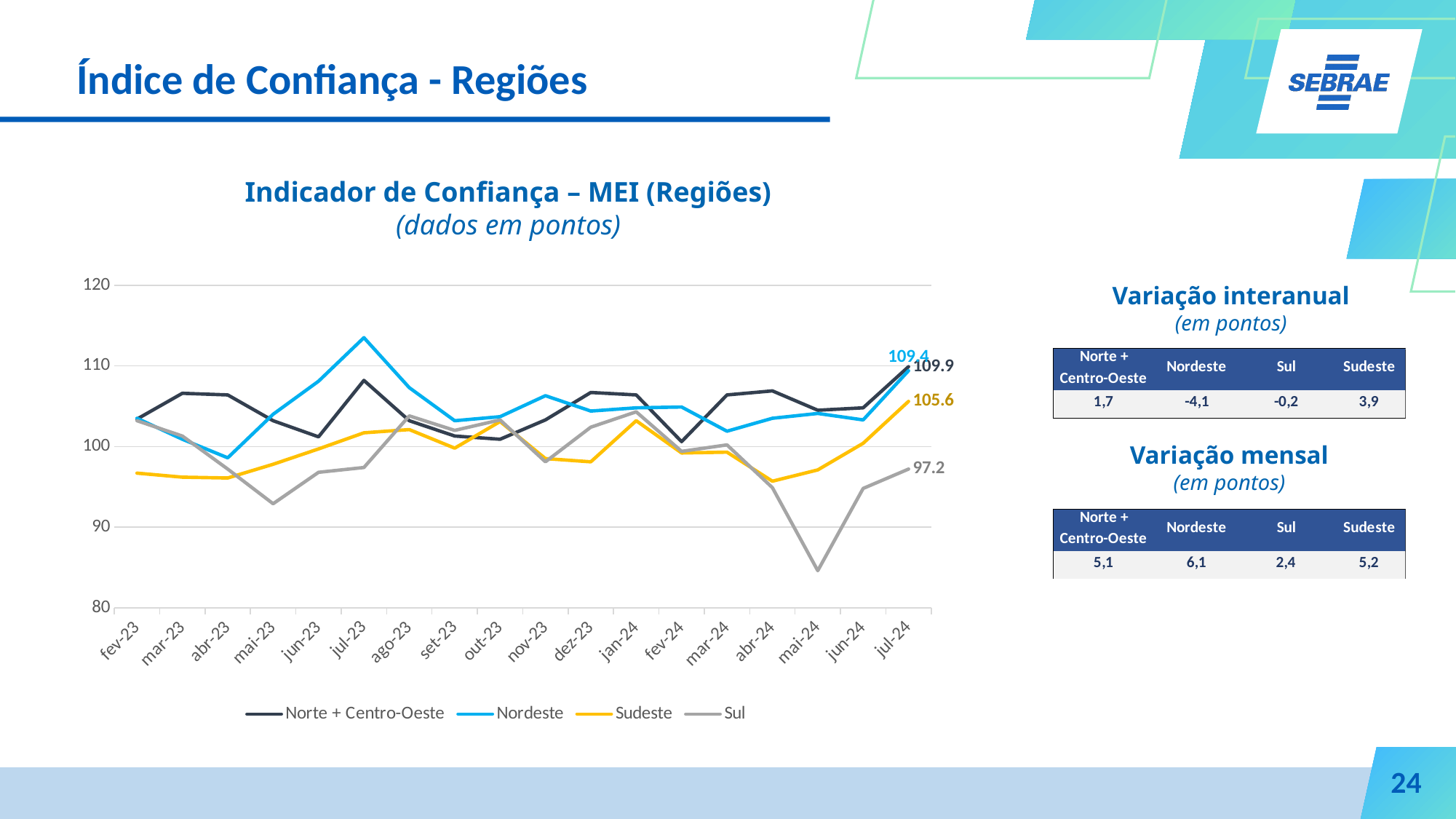
What is the value for Nordeste in jul-24? 109.4 Which series has the lowest value in jul-24? Sul What is the value for Norte + Centro-Oeste in jul-24? 109.9 Is the value for Sul in mai-24 greater or less than 90? less What kind of chart is shown on the slide? line chart Which series has the highest value in jul-24? Norte + Centro-Oeste What is the difference between the jul-24 values for Norte + Centro-Oeste and Sul? 12.7 What is the value for Sudeste in jul-24? 105.6 How many series does the legend list? 4 How many months are shown on the x axis? 18 In jul-24, which is larger: Sudeste or Sul? Sudeste What is the value for Sul in jul-24? 97.2